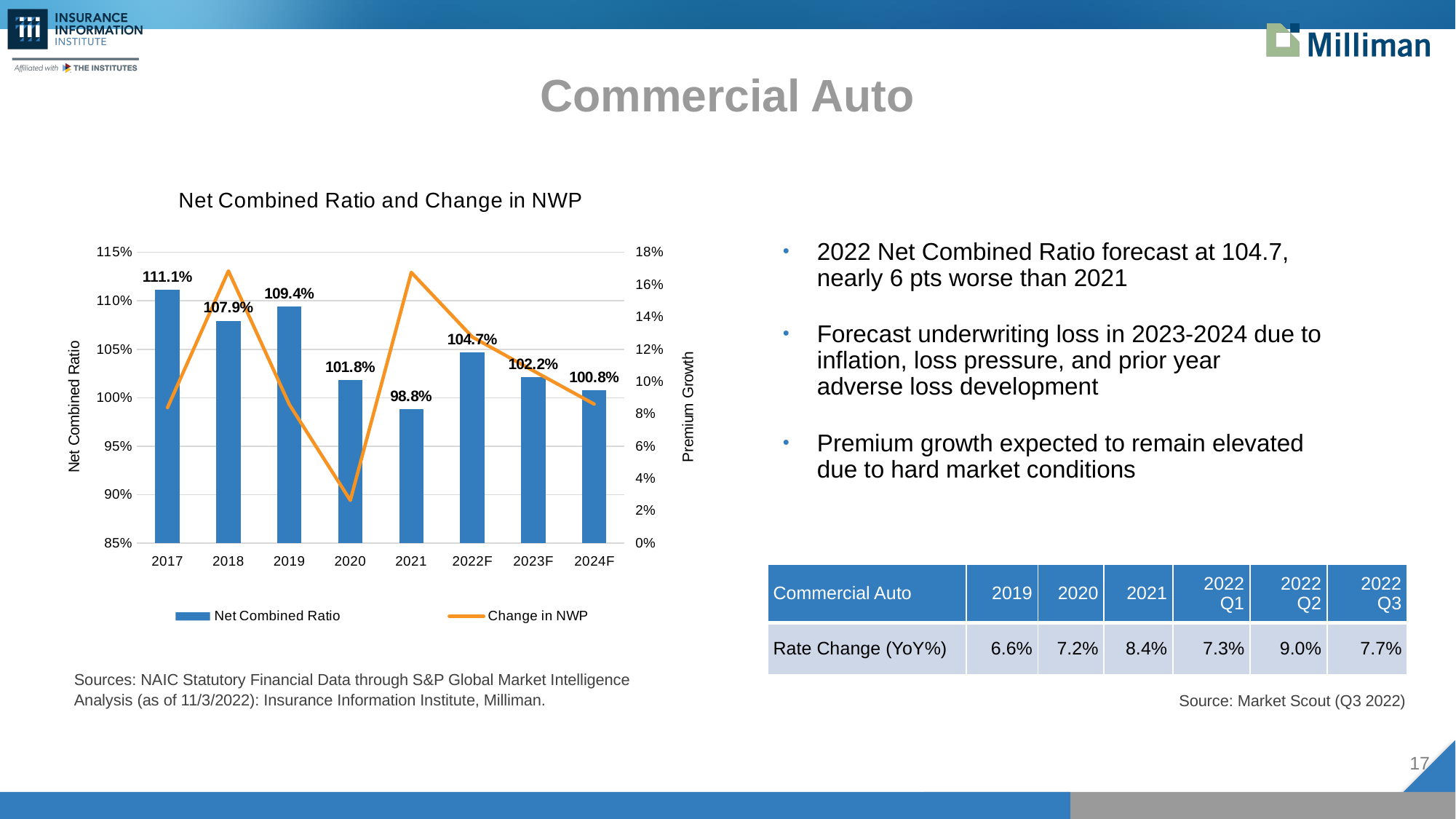
Does the Net Combined Ratio rise or fall from 2022F to 2024F? Fall How many series does the chart legend list? 2 Which year has the highest Net Combined Ratio? 2017 What kind of chart is used to show Net Combined Ratio and Change in NWP? Combined bar and line chart How many years are shown on the x axis of the chart? 8 What is the difference between the Net Combined Ratio for 2022F and 2021? 5.9 percentage points What is the Net Combined Ratio for 2022F? 104.7% What is the Net Combined Ratio for 2017? 111.1% Is the Change in NWP for 2020 greater or less than 4%? less Which year has a higher Net Combined Ratio, 2018 or 2019? 2019 Which year has the lowest Net Combined Ratio? 2021 Is the Change in NWP for 2018 greater or less than 14%? greater